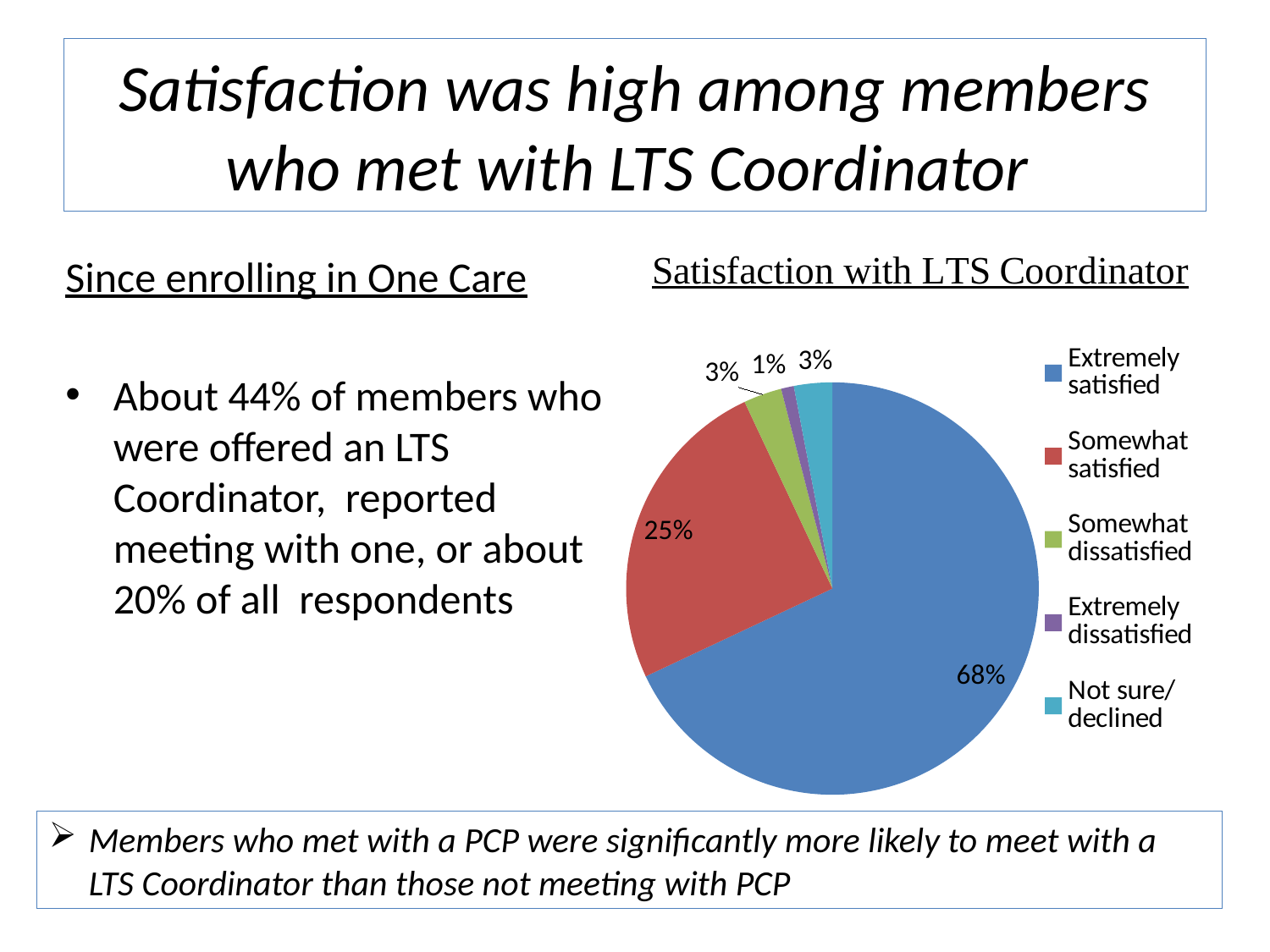
What type of chart is shown on the slide? pie chart Which category has the largest share of the pie? Extremely satisfied Which category has the smallest share of the pie? Extremely dissatisfied What percentage of respondents were Extremely satisfied with the LTS Coordinator? 68% How many categories does the legend list? 5 What is the difference between the Extremely satisfied and Somewhat satisfied shares? 43 percentage points What percentage of respondents were Somewhat satisfied? 25% What percentage of respondents answered Not sure/declined? 3% Which is larger, the Somewhat satisfied share or the Somewhat dissatisfied share? Somewhat satisfied What is the title of the chart? Satisfaction with LTS Coordinator What percentage of respondents were Extremely dissatisfied? 1% What colour is the Extremely satisfied slice? blue